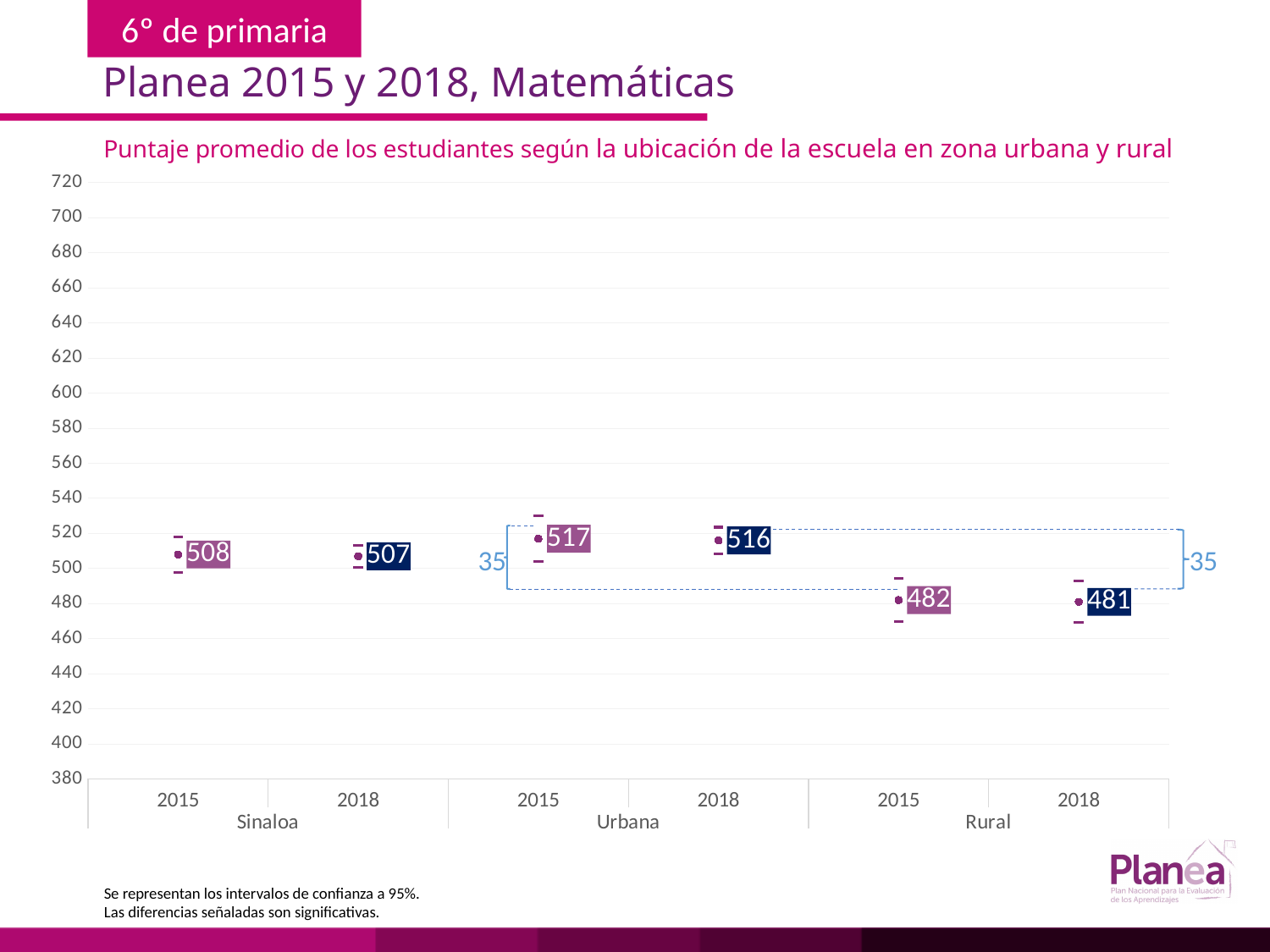
What is the average score for Urbana schools in 2015? 517 What is the difference between the Urbana and Rural average scores in 2015? 35 What is the average score for Rural schools in 2018? 481 How many data points are plotted on the chart? 6 What confidence level do the intervals shown on the chart represent? 95% Which group and year has the lowest average score? Rural 2018 What is the average score for Sinaloa in 2018? 507 Which is larger, the Sinaloa 2015 score or the Rural 2015 score? Sinaloa 2015 What is the difference between the Urbana and Rural average scores in 2018? 35 What is the average score for Sinaloa in 2015? 508 Is the Rural 2015 average score greater or less than 500? less Which group and year has the highest average score? Urbana 2015